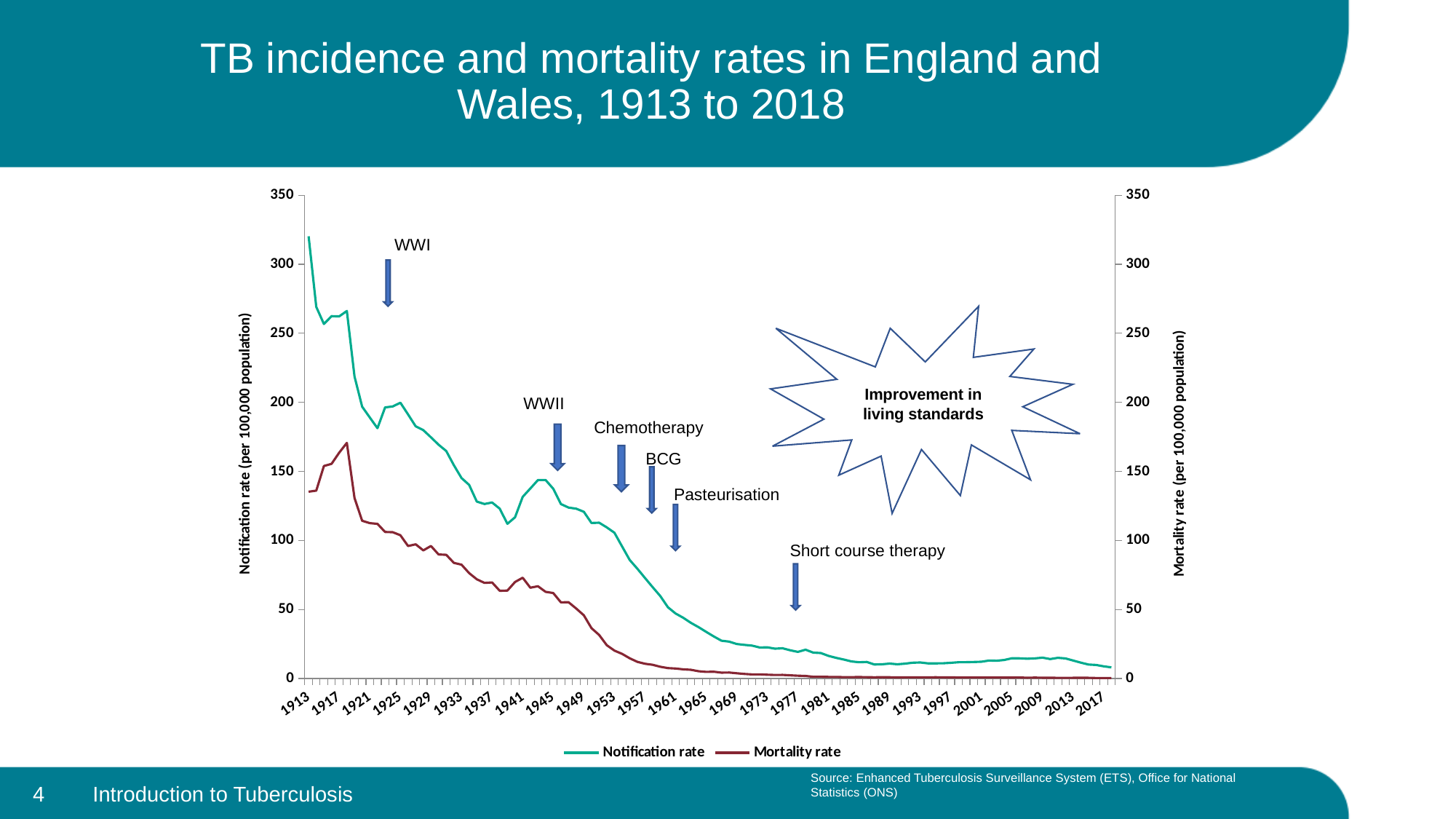
In which year shown on the x axis is the notification rate at its highest? 1913 Is the notification rate in 1945 greater or less than 100? greater How many series does the chart legend list? 2 Is the mortality rate in 1913 greater or less than 100? greater Is the notification rate in 1961 greater or less than 100? less What are the two series named in the legend? Notification rate and Mortality rate What kind of chart is shown on the slide? Line chart What is the title of the chart on the slide? TB incidence and mortality rates in England and Wales, 1913 to 2018 Overall, do the notification rate values rise or fall from 1913 to 2017? Fall In 1913, which is larger: the notification rate or the mortality rate? Notification rate